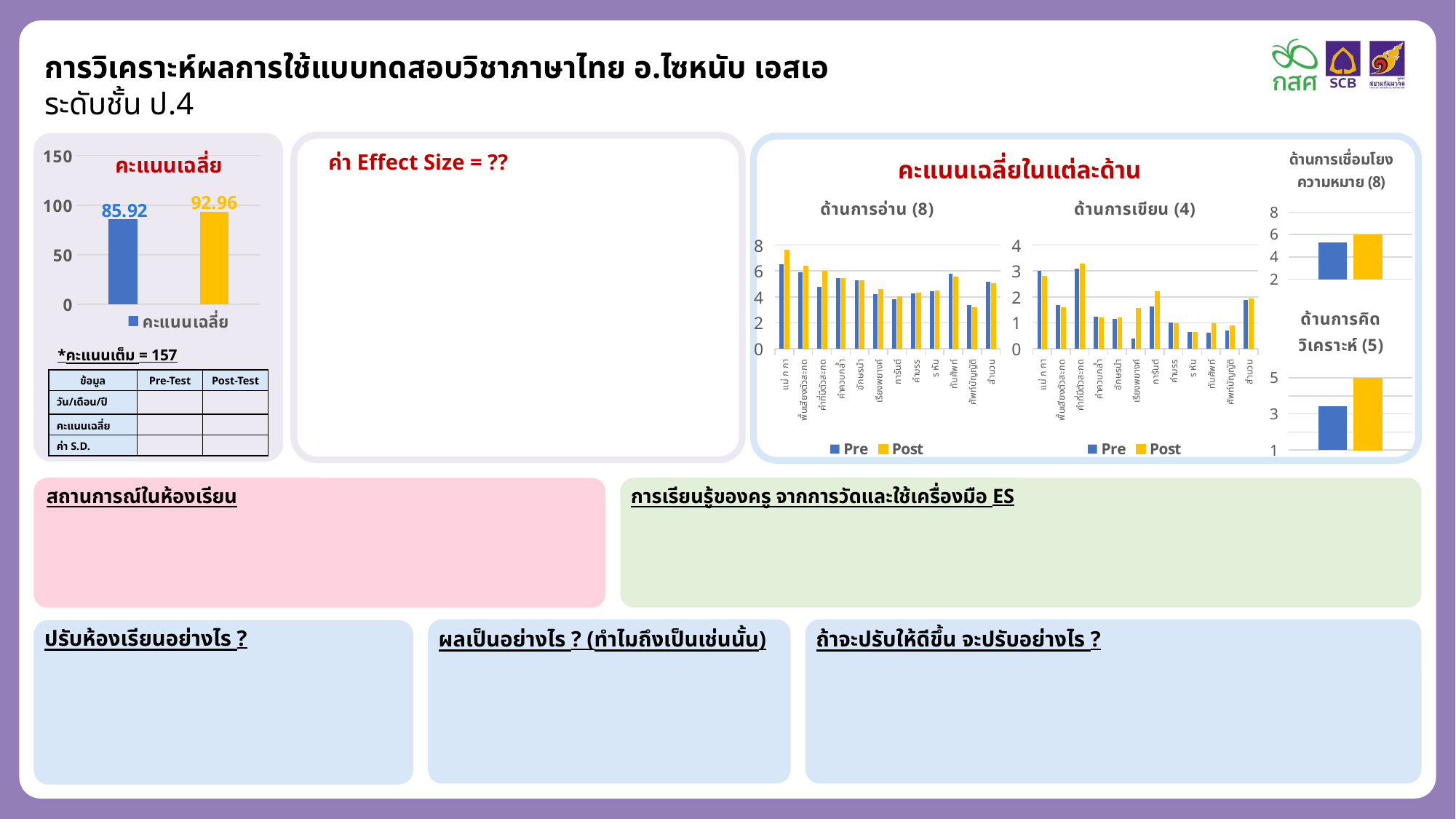
In the 'คะแนนเฉลี่ย' chart on the left, is the value of the yellow bar greater or less than 100? less What kind of chart is the 'คะแนนเฉลี่ย' chart on the left? bar chart What are the two legend entries in the 'ด้านการเขียน (4)' chart? Pre and Post In the 'คะแนนเฉลี่ย' chart on the left, what is the difference between the yellow bar and the blue bar? 7.04 In the 'คะแนนเฉลี่ย' chart on the left, which bar is taller, the blue one or the yellow one? the yellow one In the 'ด้านการคิดวิเคราะห์ (5)' chart, is the Post value greater or less than 3? greater In the 'ด้านการอ่าน (8)' chart, how many series does the legend list? 2 In the 'ด้านการเชื่อมโยงความหมาย (8)' chart, is the Post value greater or less than 4? greater In the 'คะแนนเฉลี่ย' chart on the left, what value is shown on the yellow bar? 92.96 How many bars are plotted in the 'คะแนนเฉลี่ย' chart on the left? 2 In the 'ด้านการอ่าน (8)' chart, how many categories are shown on the x axis? 12 In the 'คะแนนเฉลี่ย' chart on the left, what value is shown on the blue bar? 85.92